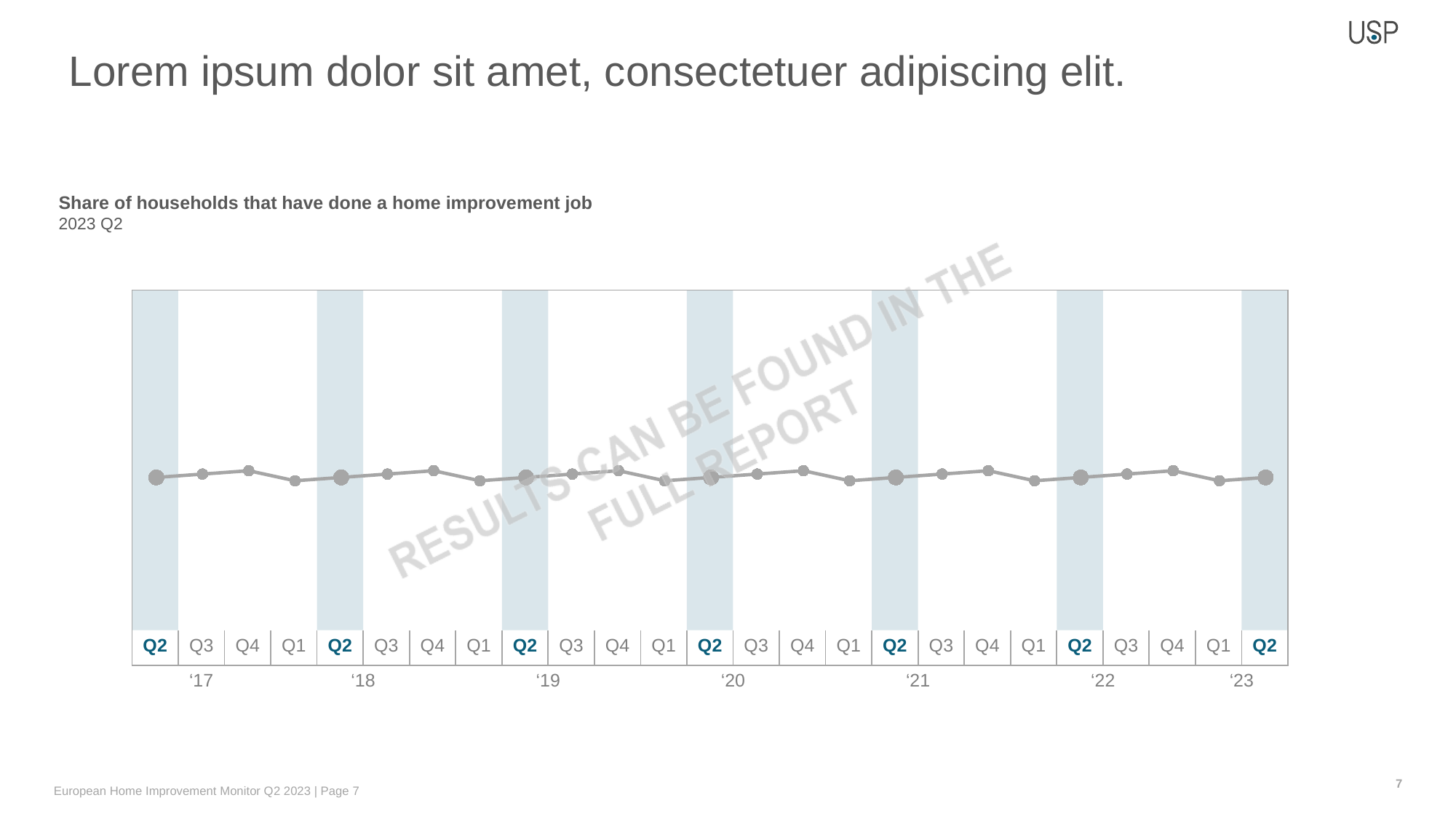
How many Q2 points are marked with larger dots on the line? 7 Which quarter labels are highlighted in bold with shaded columns on the chart? Q2 What is the title of the chart? Share of households that have done a home improvement job What is the first quarter shown on the x axis of the chart? Q2 '17 How many data points are plotted on the line? 25 What is the last quarter shown on the x axis of the chart? Q2 '23 What kind of chart is shown on the slide? line chart How many year labels appear along the x axis of the chart? 7